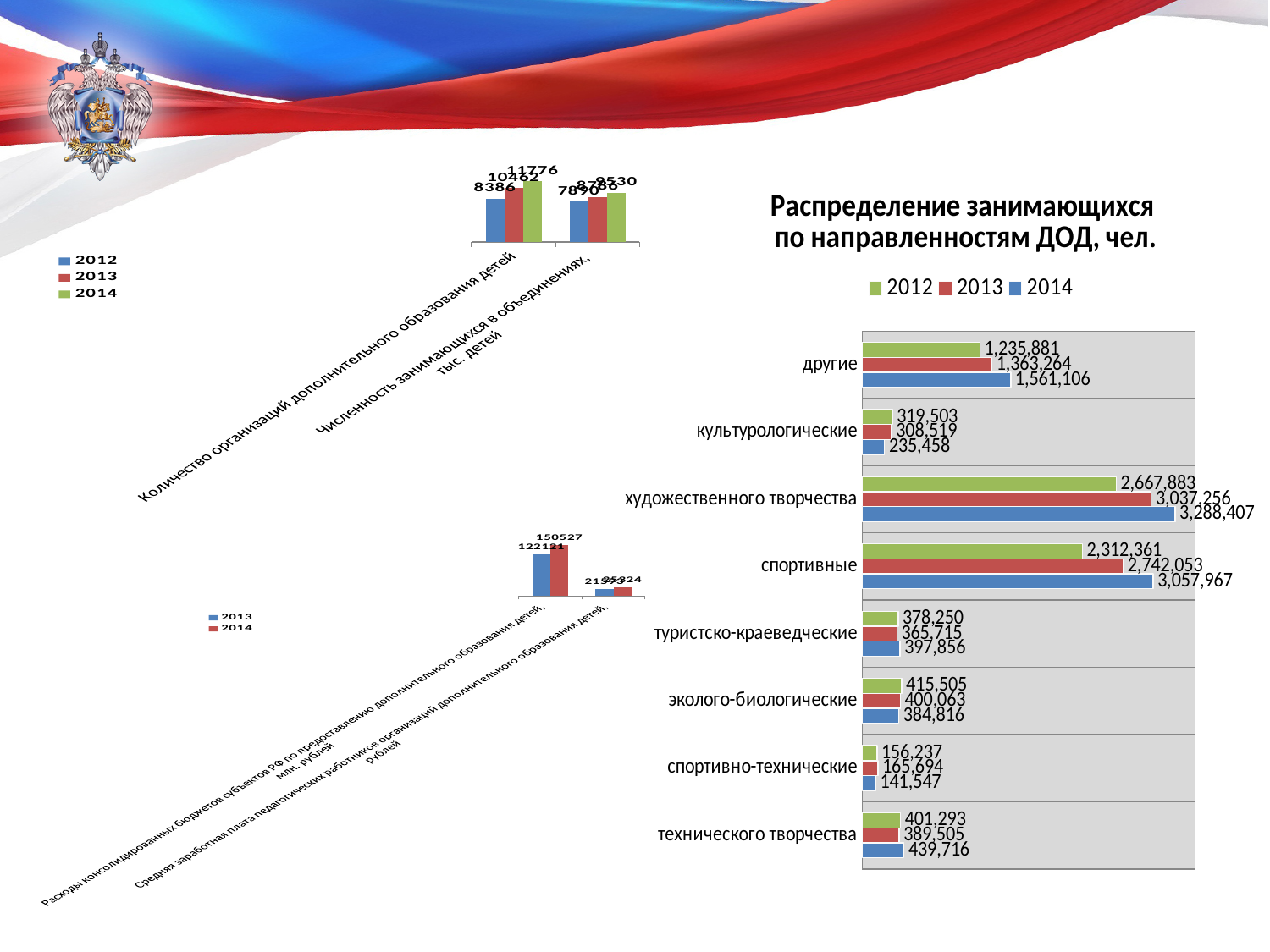
On the chart titled 'Распределение занимающихся по направленностям ДОД, чел.', what is the difference between the 2014 and 2012 values for 'другие'? 325,225 On the chart titled 'Распределение занимающихся по направленностям ДОД, чел.', do the values for 'спортивные' rise or fall from 2012 to 2014? rise What kind of chart is the one titled 'Распределение занимающихся по направленностям ДОД, чел.'? bar chart On the top-left chart, what is the 2012 value for 'Количество организаций дополнительного образования детей'? 8386 On the chart titled 'Распределение занимающихся по направленностям ДОД, чел.', which category has the lowest 2013 value? спортивно-технические On the chart titled 'Распределение занимающихся по направленностям ДОД, чел.', how many series does the legend list? 3 On the chart titled 'Распределение занимающихся по направленностям ДОД, чел.', which category has the highest 2014 value? художественного творчества On the chart titled 'Распределение занимающихся по направленностям ДОД, чел.', what is the 2012 value for 'спортивные'? 2,312,361 On the bottom-left chart, how many series does the legend list? 2 On the chart titled 'Распределение занимающихся по направленностям ДОД, чел.', how many categories are shown? 8 On the chart titled 'Распределение занимающихся по направленностям ДОД, чел.', what is the 2014 value for 'художественного творчества'? 3,288,407 On the chart titled 'Распределение занимающихся по направленностям ДОД, чел.', which year has the larger value for 'культурологические', 2012 or 2014? 2012